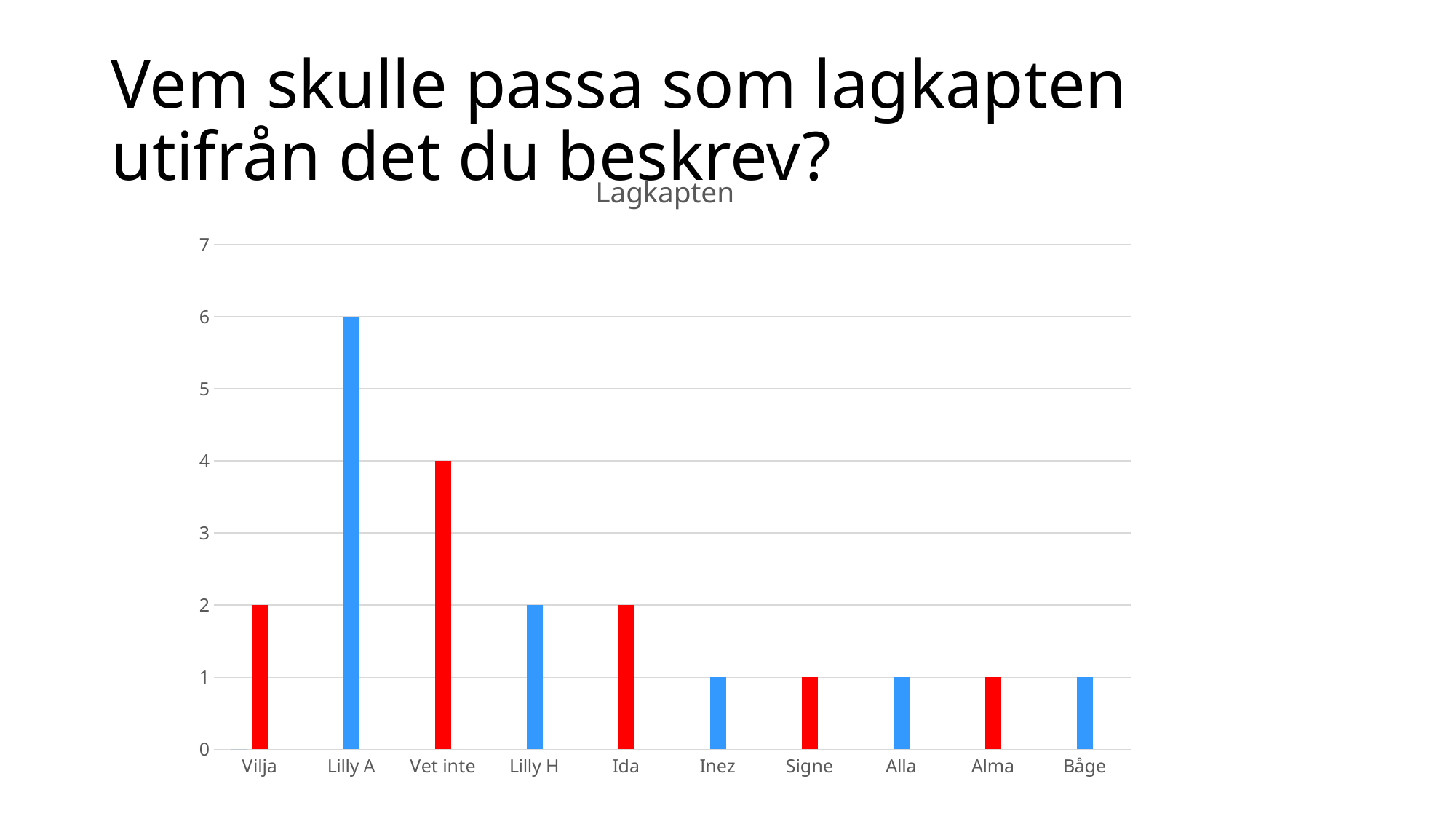
What is the difference between the values for Lilly A and Vet inte? 2 What is the value for Vilja? 2 How many categories have a value of 1? 5 What type of chart is shown on the slide? bar chart Which category has the highest value in the chart? Lilly A What is the value for Vet inte? 4 Which is larger, the value for Ida or the value for Signe? Ida What is the title of the chart? Lagkapten How many categories are shown on the x axis of the chart? 10 Is the value for Lilly A greater or less than 5? greater What is the value for Lilly A? 6 What is the value for Inez? 1